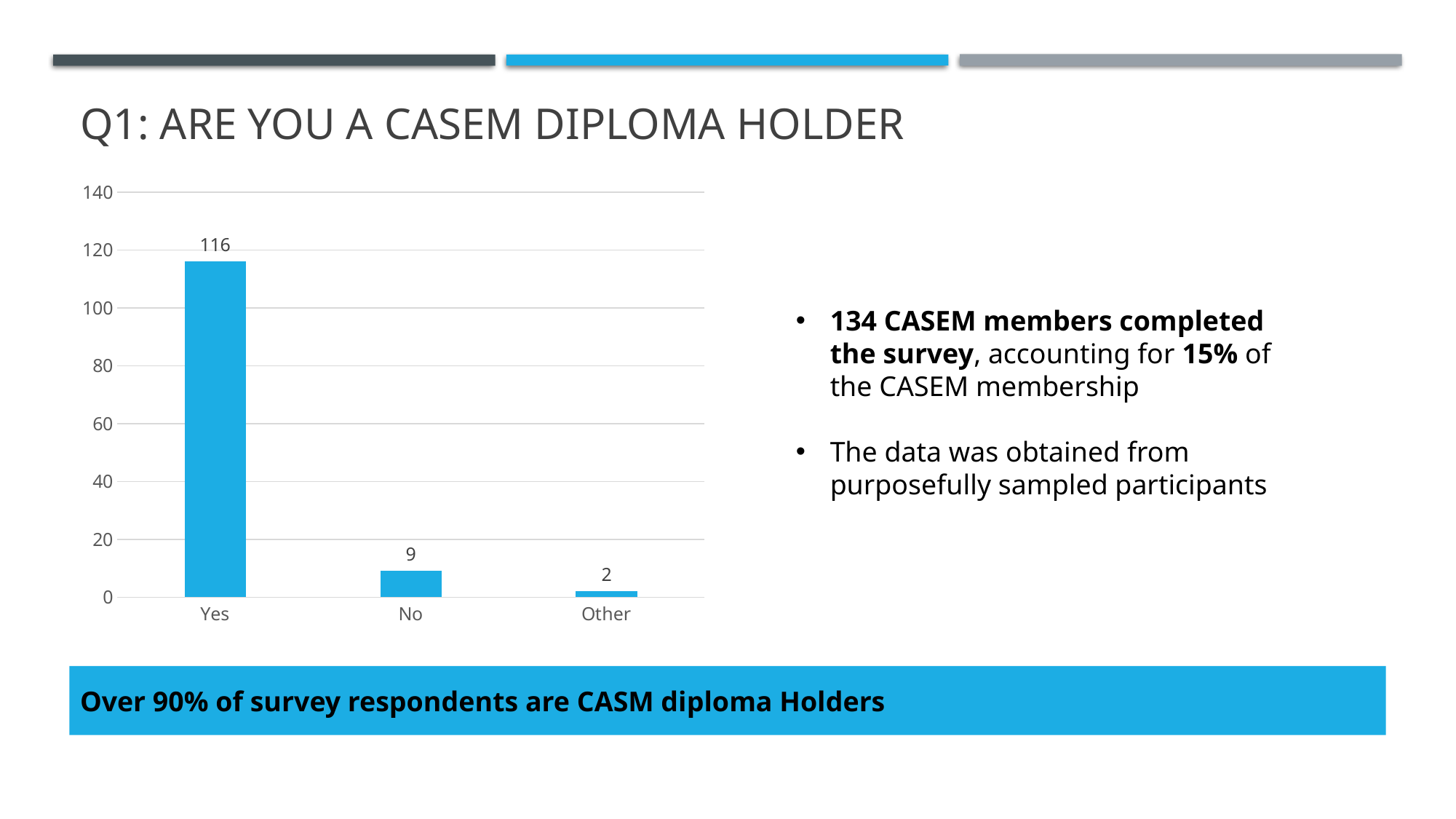
Is the value for Yes greater or less than 100? greater What is the value for Other? 2 What is the difference between the values for No and Other? 7 Which category has the lowest value? Other What is the value for Yes? 116 Which is larger, the value for No or the value for Other? No Which category has the highest value? Yes What kind of chart is shown on the slide? bar chart What is the value for No? 9 Do the values rise or fall from Yes to Other along the x axis? fall What is the difference between the values for Yes and No? 107 How many categories are shown on the x axis? 3